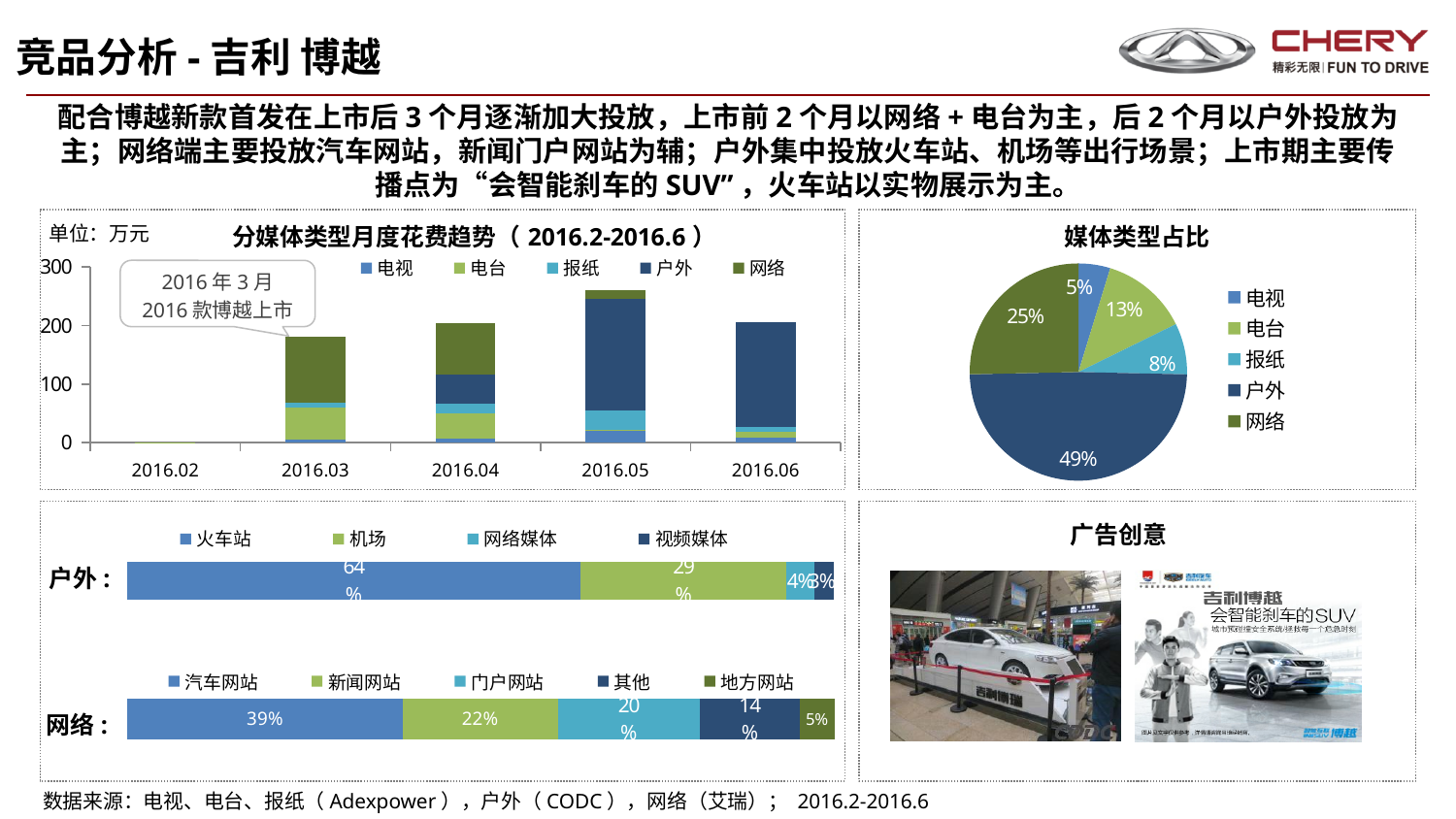
In the 网络 bar at the bottom left, what share does 汽车网站 have? 39% In the 户外 bar at the bottom left, what is the difference between the shares of 火车站 and 机场? 35% What kind of chart is 分媒体类型月度花费趋势? stacked bar chart In the pie chart 媒体类型占比, what share does 户外 have? 49% In the chart 分媒体类型月度花费趋势, which month has the highest total spend? 2016.05 In the chart 分媒体类型月度花费趋势, how many series does the legend list? 5 In the pie chart 媒体类型占比, which media type has the largest share? 户外 In the pie chart 媒体类型占比, what is the difference between the shares of 户外 and 网络? 24% In the chart 分媒体类型月度花费趋势, how many months are shown on the x axis? 5 In the 户外 bar at the bottom left, what share does 火车站 have? 64% In the chart 分媒体类型月度花费趋势, is the total for 2016.05 greater or less than 200? greater In the pie chart 媒体类型占比, which media type has the smallest share? 电视